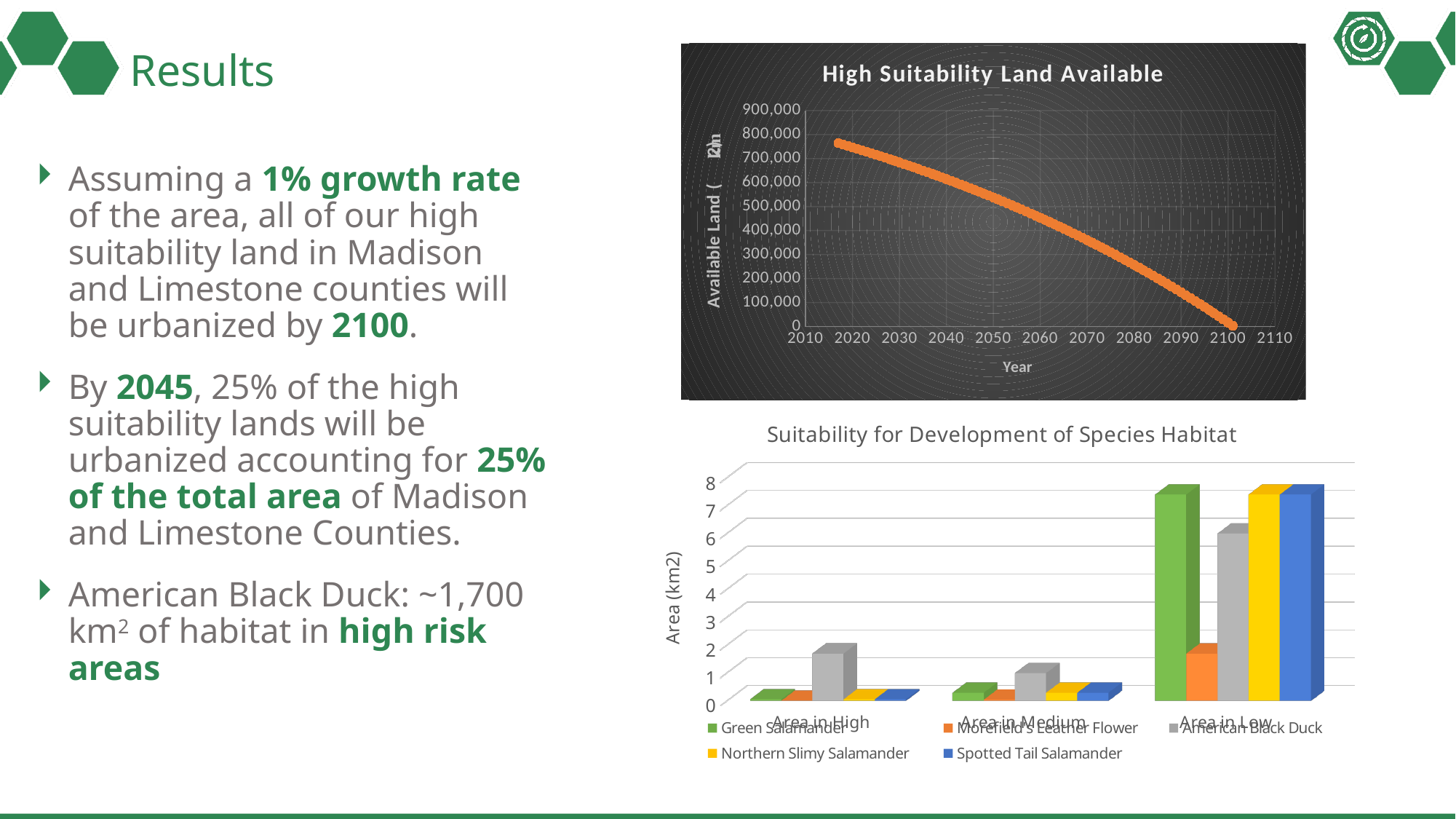
In the Suitability for Development of Species Habitat chart, is the Green Salamander value larger for Area in Low or Area in High? Area in Low In the High Suitability Land Available chart, do the values rise or fall as the year increases? fall What is the title of the top chart? High Suitability Land Available How many series does the legend of the Suitability for Development of Species Habitat chart list? 5 What kind of chart is the Suitability for Development of Species Habitat chart? bar chart In the Suitability for Development of Species Habitat chart, is the American Black Duck value for Area in High greater or less than 1? greater How many categories are shown on the x axis of the Suitability for Development of Species Habitat chart? 3 In the High Suitability Land Available chart, is the available land in 2090 greater or less than 300,000? less In the High Suitability Land Available chart, is the available land in 2030 greater or less than 600,000? greater In the Suitability for Development of Species Habitat chart, which species has the lowest value in the Area in Low category? Morefield's Leather Flower In the Suitability for Development of Species Habitat chart, which species has the highest value in the Area in High category? American Black Duck